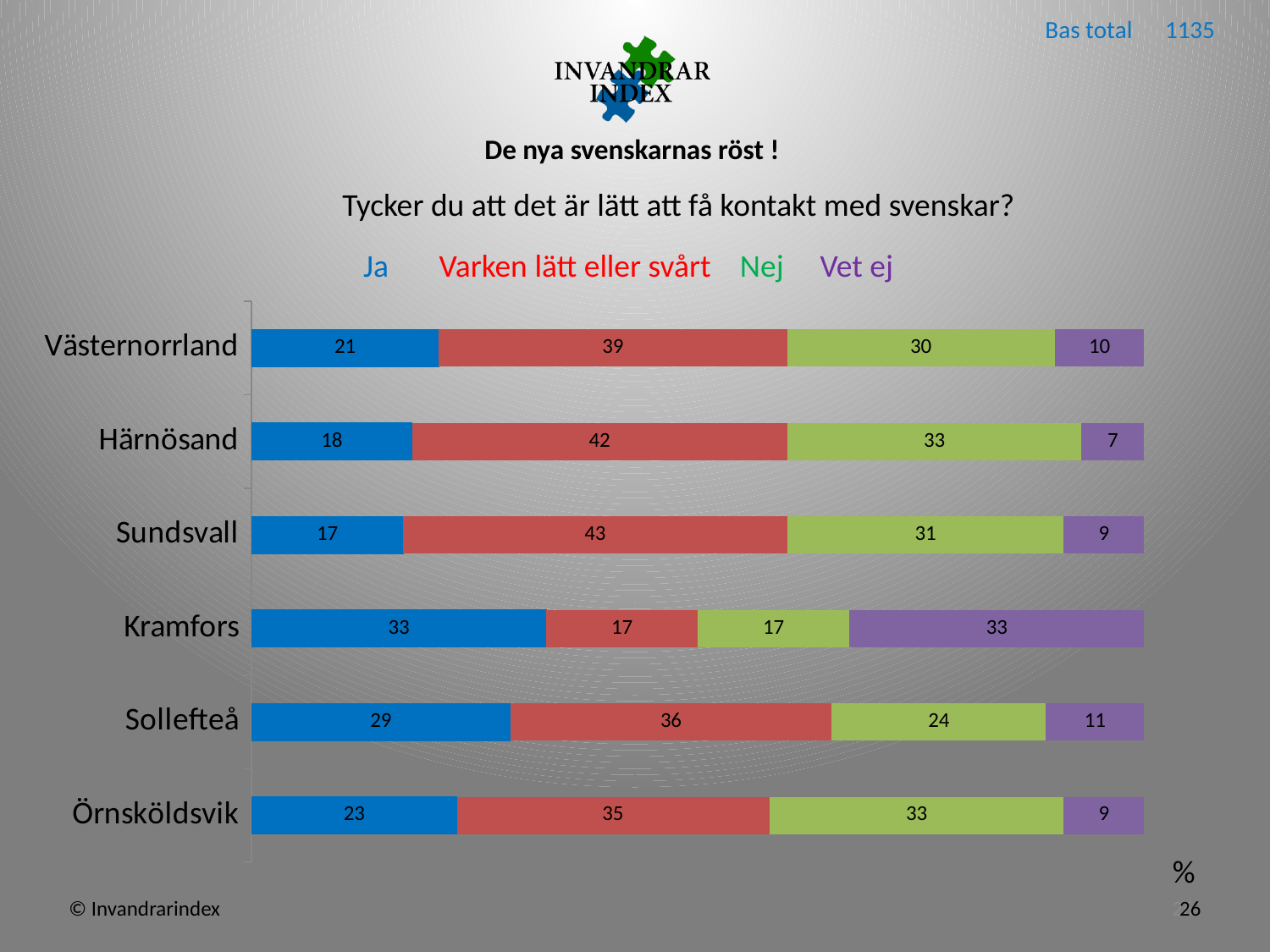
What is the value for "Ja" for Kramfors? 33 What is the value for "Nej" for Sollefteå? 24 Which category has the highest value for "Ja"? Kramfors How many series does the legend list? 4 How many categories are shown on the chart? 6 What is the value for "Varken lätt eller svårt" for Sundsvall? 43 Which category has the lowest value for "Vet ej"? Härnösand What is the difference between the "Varken lätt eller svårt" values for Härnösand and Örnsköldsvik? 7 What is the value for "Vet ej" for Härnösand? 7 Which is larger: the "Nej" value for Västernorrland or the "Nej" value for Sundsvall? Sundsvall What is the total of the stacked bar for Sollefteå? 100 What kind of chart is shown on the slide? Stacked bar chart